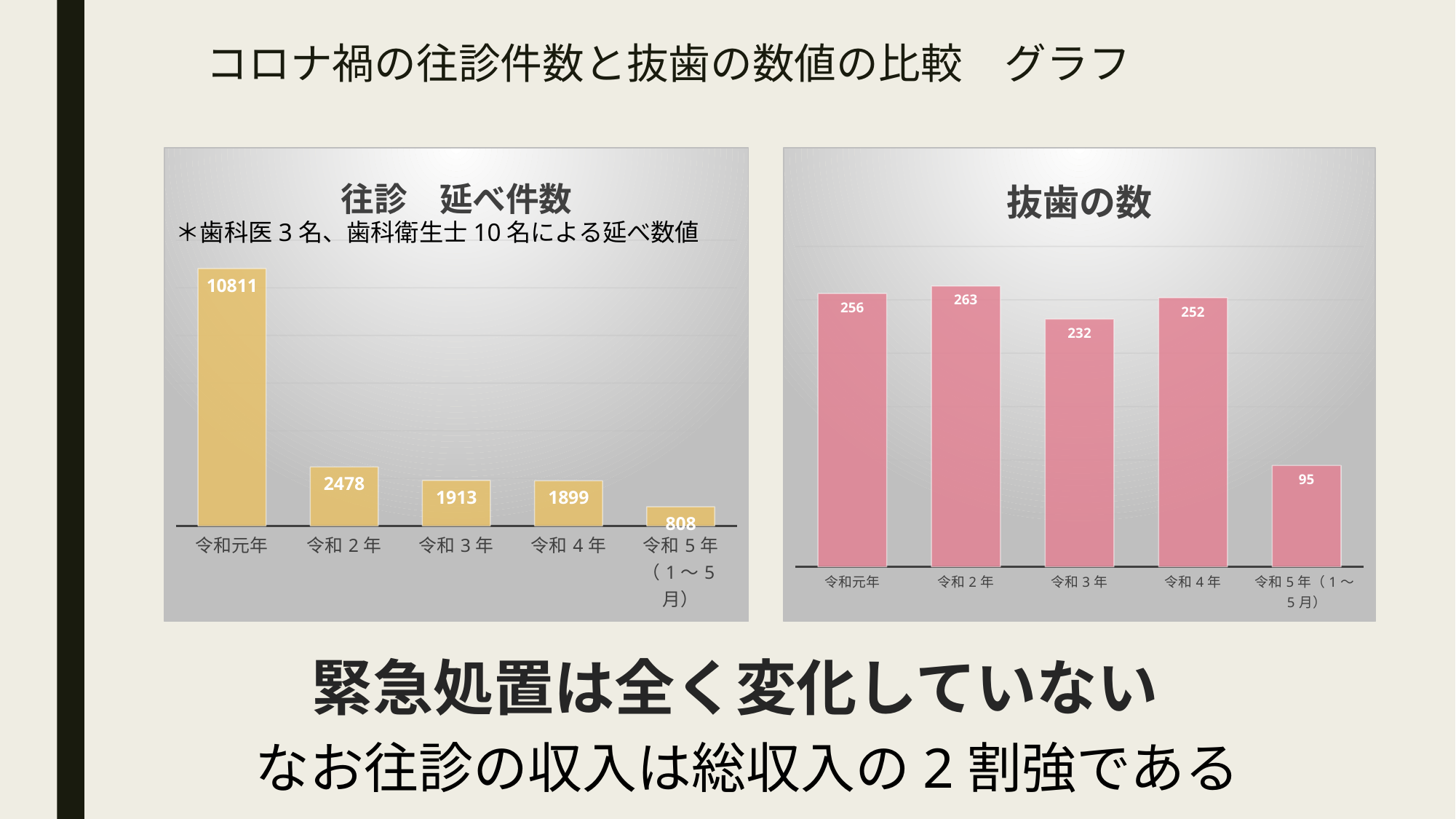
In the 抜歯の数 chart, which is larger, 令和元年 or 令和４年? 令和元年 In the 往診 延べ件数 chart, do the values rise or fall from 令和元年 to 令和５年? fall In the 往診 延べ件数 chart, what is the value for 令和元年? 10811 What type of chart is the 往診 延べ件数 chart? bar chart In the 抜歯の数 chart, what is the value for 令和３年? 232 In the 往診 延べ件数 chart, what is the difference between 令和２年 and 令和３年? 565 In the 抜歯の数 chart, what is the difference between 令和２年 and 令和３年? 31 In the 往診 延べ件数 chart, which year has the lowest value? 令和５年（１～５月） In the 抜歯の数 chart, what is the value for 令和５年（１～５月）? 95 In the 抜歯の数 chart, which year has the highest value? 令和２年 In the 往診 延べ件数 chart, what is the value for 令和４年? 1899 How many categories does the 抜歯の数 chart show? 5